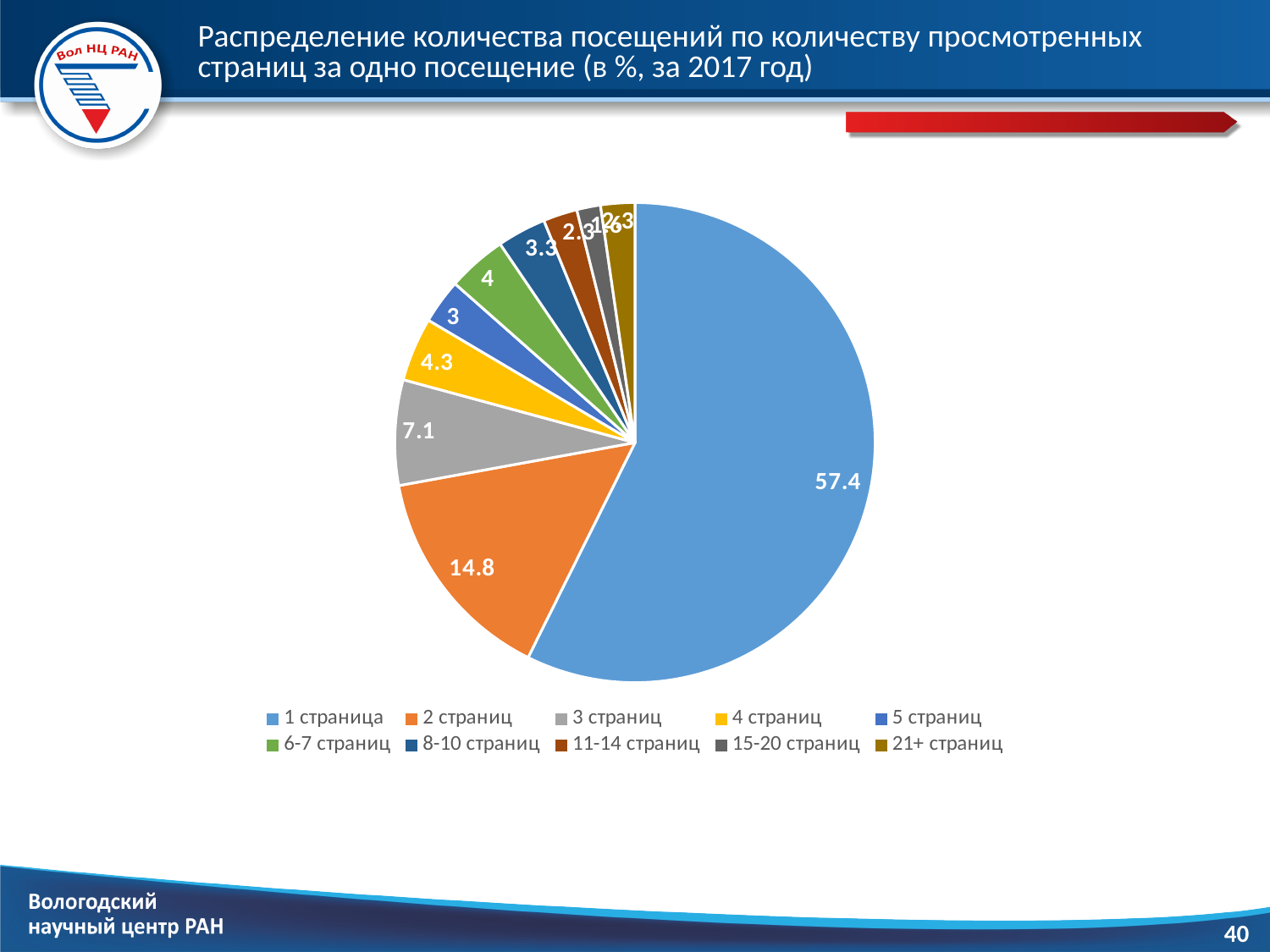
What kind of chart is shown on the slide? pie chart What is the value for "1 страница"? 57.4 How many categories does the legend list? 10 Which is larger, the value for "2 страниц" or the value for "3 страниц"? 2 страниц What is the value for "2 страниц"? 14.8 What is the difference between the values for "1 страница" and "2 страниц"? 42.6 Which category has the largest slice of the pie? 1 страница What is the value for "6-7 страниц"? 4 What is the value for "3 страниц"? 7.1 What share of the pie does the "1 страница" slice represent? 57.4% What is the value for "8-10 страниц"? 3.3 What is the value for "4 страниц"? 4.3